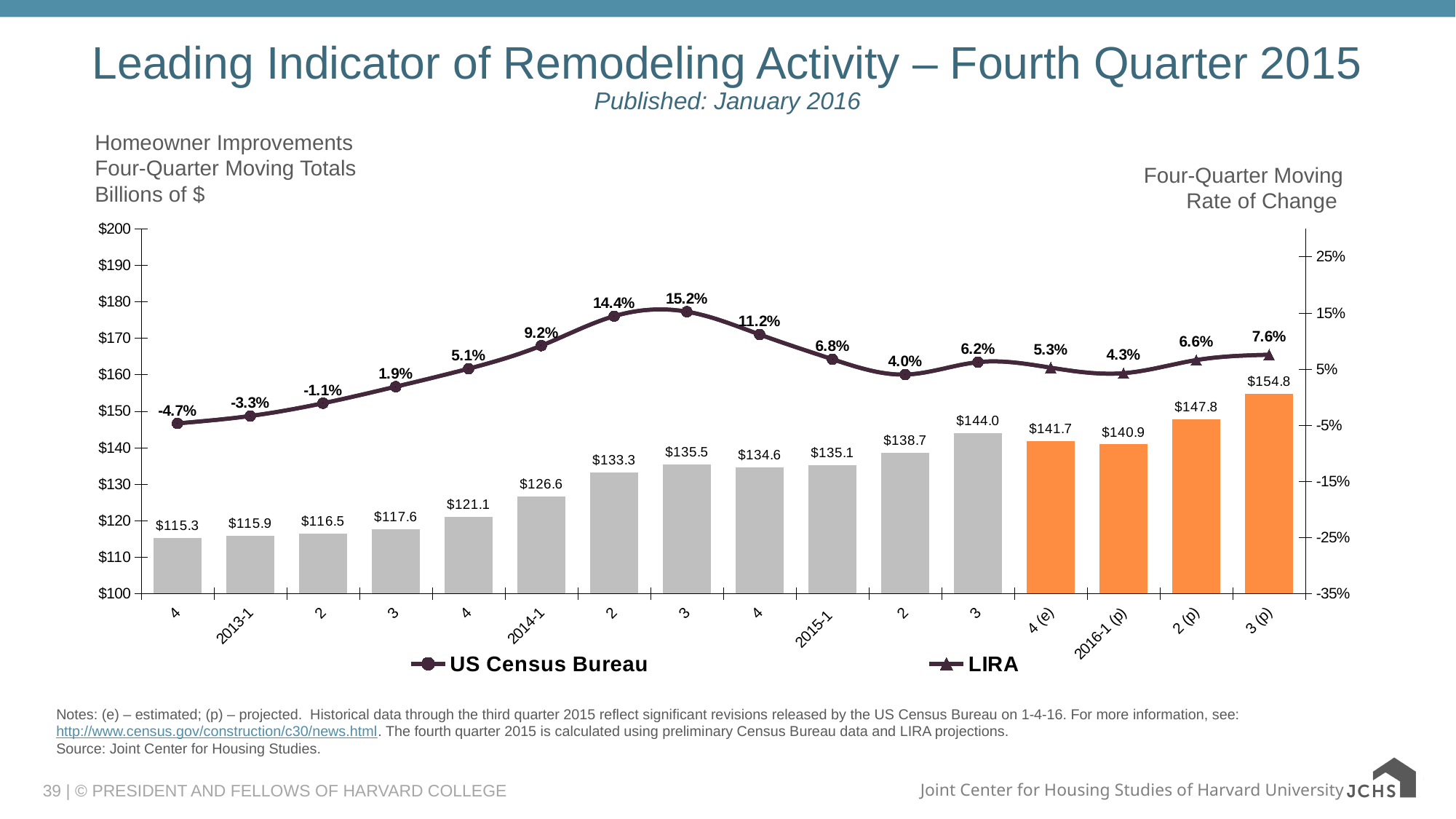
How many bars (quarters) are plotted in the chart? 16 How many series does the legend list? 2 What is the four-quarter moving total for 2015-1? $135.1 Which quarter has the highest four-quarter moving rate of change? 3 (2014) What are the two series named in the legend? US Census Bureau and LIRA What kind of chart is shown on the slide? Combination bar and line chart Which is larger, the four-quarter moving total for 3 of 2015 or for 4 (e) of 2015? 3 of 2015 ($144.0) What is the projected four-quarter moving total for 3 (p) of 2016? $154.8 Do the four-quarter moving totals generally rise or fall from 4 (2012) to 3 (p) of 2016? Rise What is the four-quarter moving rate of change for 2014-1? 9.2% Which quarter has the lowest four-quarter moving total? 4 (2012) What is the difference between the four-quarter moving totals for 2 (p) and 2016-1 (p)? $6.9